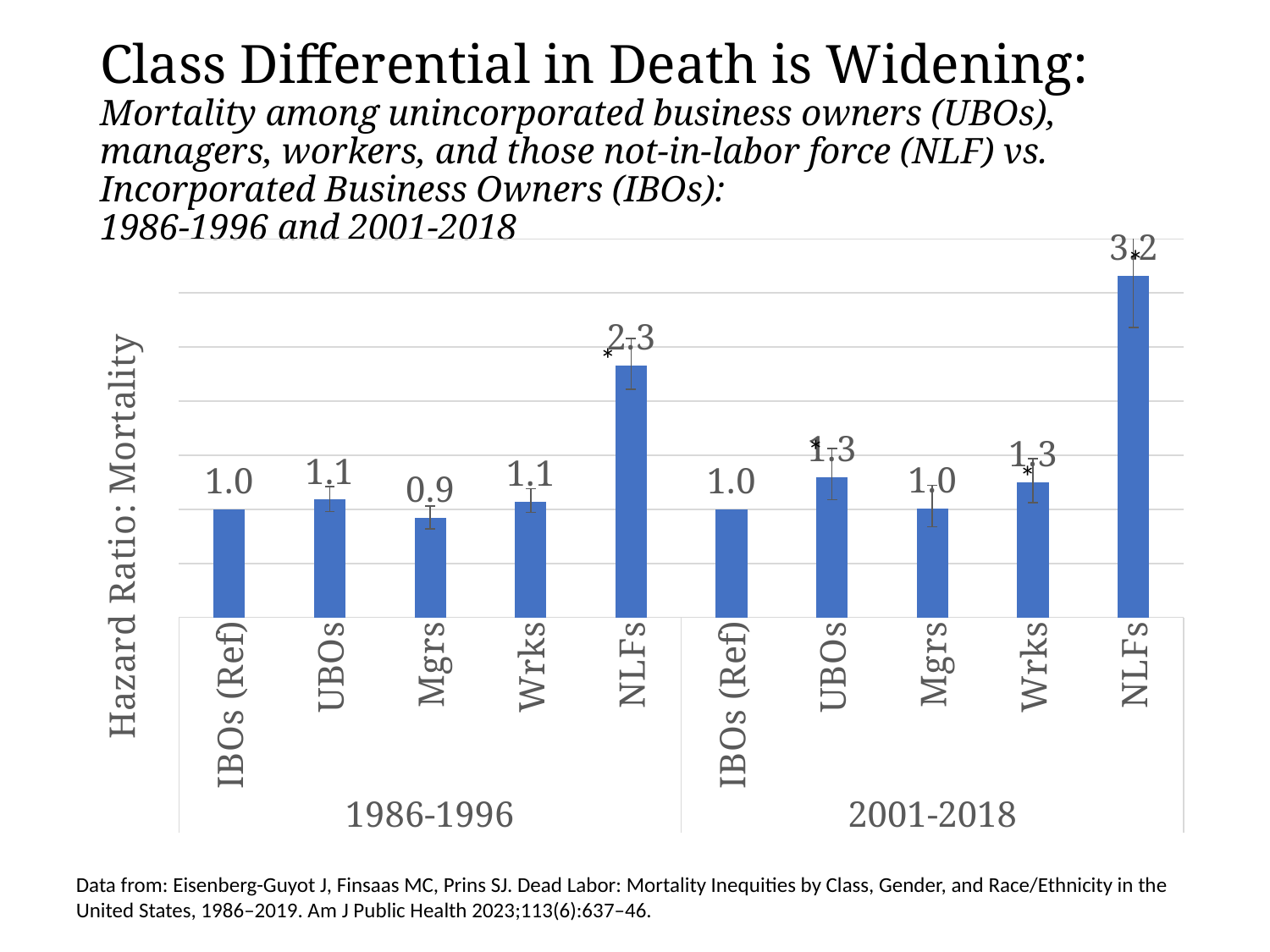
What is the hazard ratio for UBOs in the 2001-2018 period? 1.3 What is the hazard ratio for NLFs in the 1986-1996 period? 2.3 What is the hazard ratio for Wrks in the 1986-1996 period? 1.1 What is the difference between the NLFs hazard ratio in 2001-2018 and in 1986-1996? 0.9 What is the hazard ratio for Mgrs in the 1986-1996 period? 0.9 Which is larger: the hazard ratio for UBOs in 1986-1996 or for UBOs in 2001-2018? UBOs in 2001-2018 Which category has the highest hazard ratio across the whole chart? NLFs (2001-2018) How many bars are plotted in the chart? 10 Which category has the lowest hazard ratio across the whole chart? Mgrs (1986-1996) What is the label of the vertical axis? Hazard Ratio: Mortality What is the hazard ratio for NLFs in the 2001-2018 period? 3.2 What type of chart is shown on the slide? Bar chart